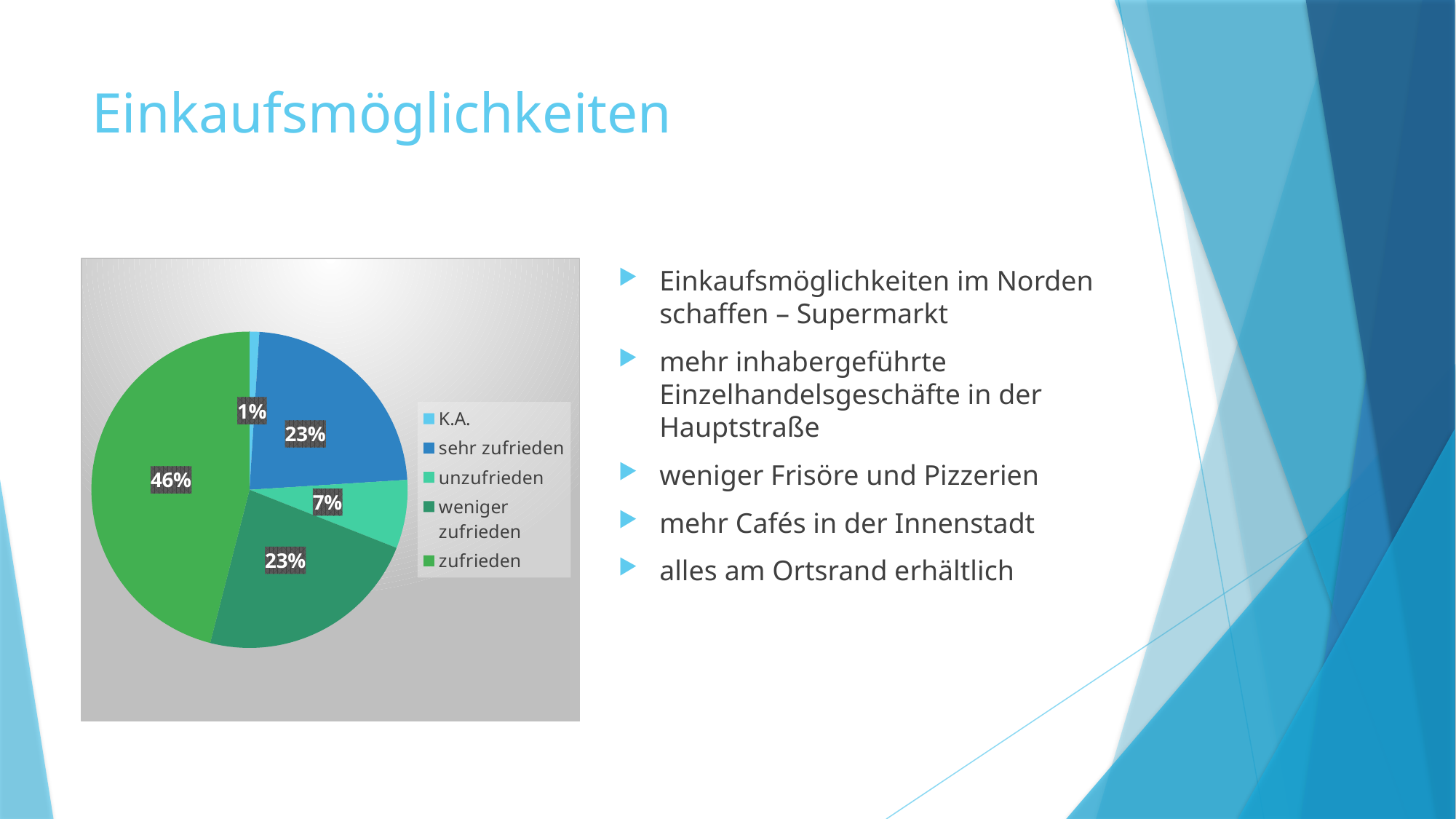
What share of the pie does "sehr zufrieden" have? 23% What share of the pie does "zufrieden" have? 46% What kind of chart is shown on the slide? pie chart Which legend entry is shown in light blue? K.A. How many categories does the pie chart show? 5 What is the difference in percentage points between "zufrieden" and "sehr zufrieden"? 23 Which category has the smallest slice of the pie? K.A. What share of the pie does "unzufrieden" have? 7% Which is larger, the share for "unzufrieden" or the share for "weniger zufrieden"? weniger zufrieden Which category has the largest slice of the pie? zufrieden